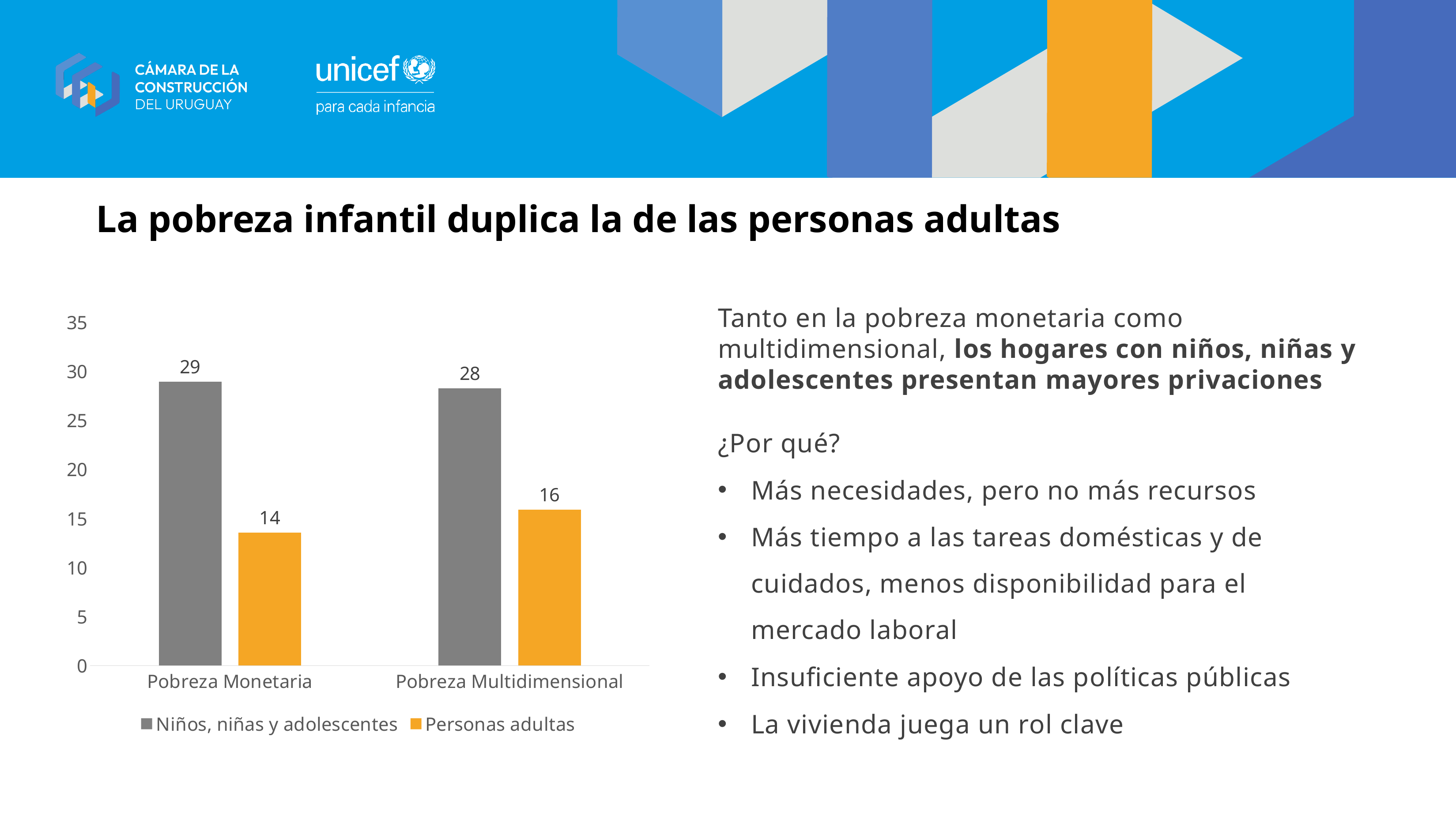
What is the difference between Niños, niñas y adolescentes and Personas adultas under Pobreza Monetaria? 15 How many series does the legend list? 2 What kind of chart is shown on the slide? Bar chart Which is larger: Personas adultas under Pobreza Monetaria or Personas adultas under Pobreza Multidimensional? Pobreza Multidimensional What is the value for Niños, niñas y adolescentes under Pobreza Multidimensional? 28 What is the value for Niños, niñas y adolescentes under Pobreza Monetaria? 29 What is the difference between Niños, niñas y adolescentes and Personas adultas under Pobreza Multidimensional? 12 Which bar has the highest value in the chart? Niños, niñas y adolescentes, Pobreza Monetaria What is the value for Personas adultas under Pobreza Multidimensional? 16 Which bar has the lowest value in the chart? Personas adultas, Pobreza Monetaria What is the value for Personas adultas under Pobreza Monetaria? 14 How many categories are shown on the x axis? 2